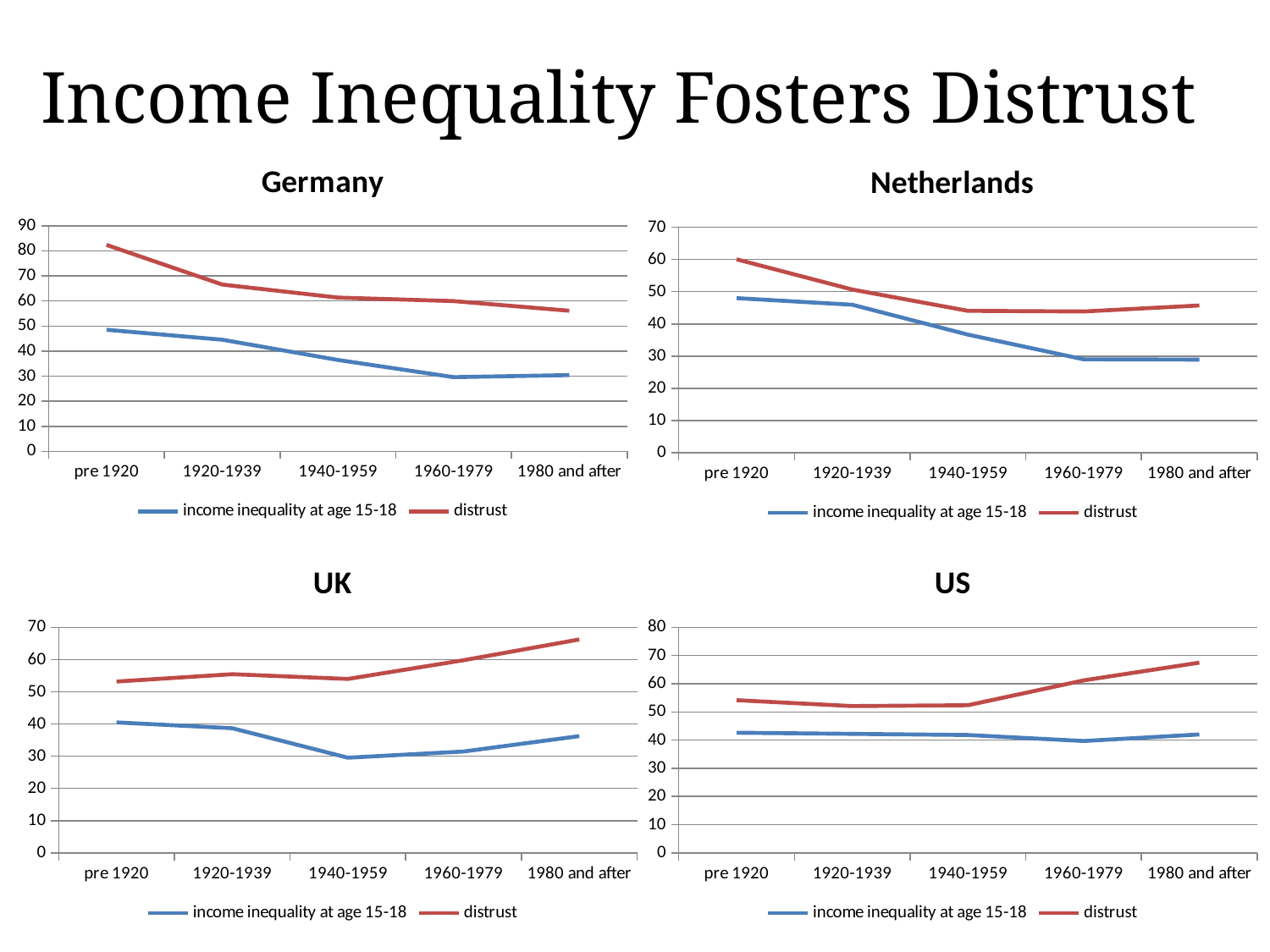
In the UK chart, in which period is distrust highest? 1980 and after What kind of chart is the Germany chart? line chart In the Germany chart, is the distrust value for pre 1920 greater or less than 70? greater In the Netherlands chart, is the income inequality at age 15-18 value for 1980 and after greater or less than 40? less How many series does the legend of the US chart list? 2 In the Germany chart, is the income inequality at age 15-18 value for 1960-1979 greater or less than 40? less In the Germany chart, does the income inequality at age 15-18 series generally rise or fall from pre 1920 to 1980 and after? fall How many time periods are shown on the x axis of the UK chart? 5 In the US chart, does the distrust series rise or fall from 1940-1959 to 1980 and after? rise In the Germany chart, which series has the larger value for pre 1920, income inequality at age 15-18 or distrust? distrust